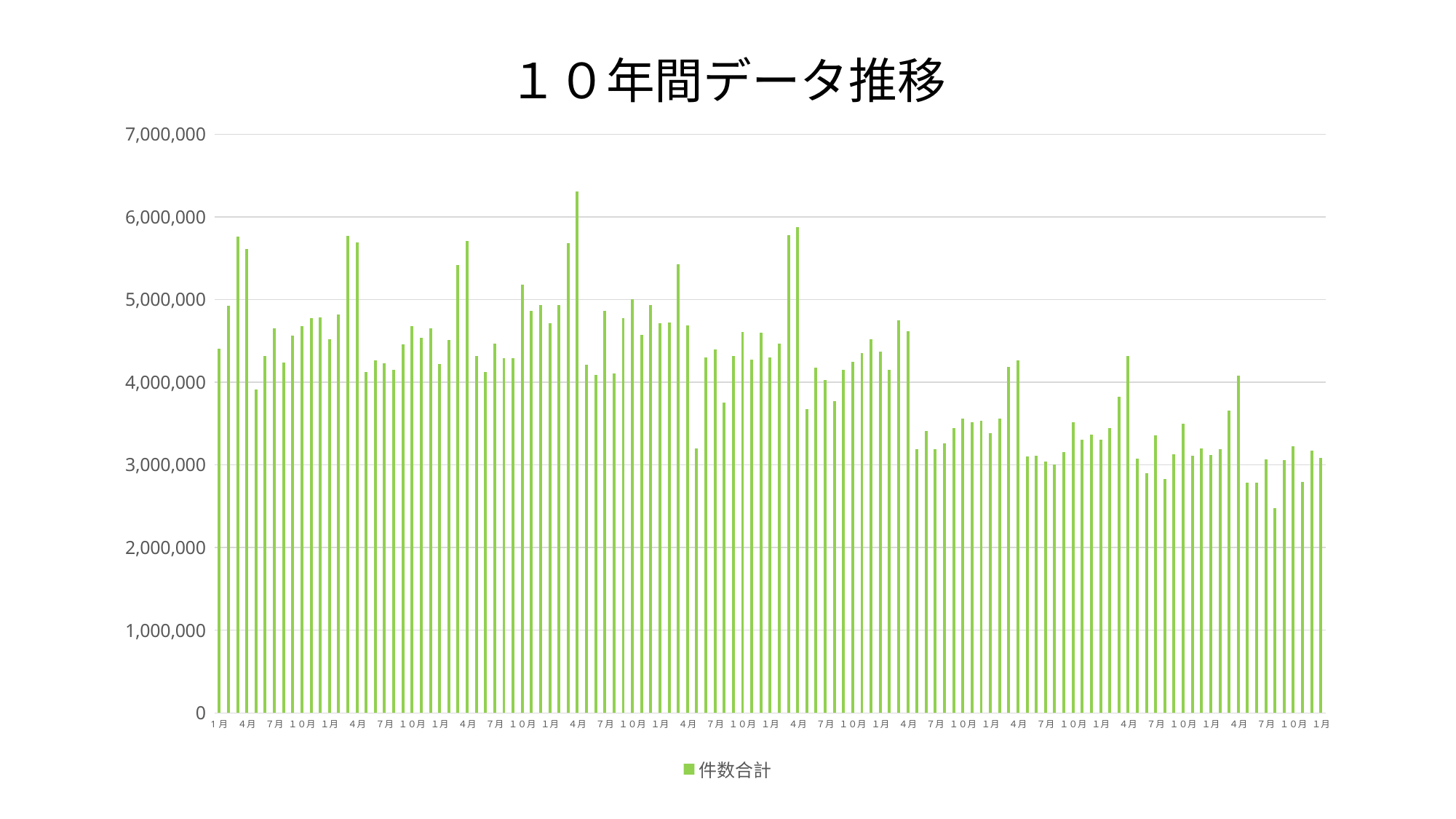
Is the value of the tallest bar greater or less than 6,000,000? greater Overall, do the values rise or fall from the left of the x axis to the right? fall What is the title of the chart? １０年間データ推移 Which is larger, the value of the leftmost bar or the value of the rightmost bar? the leftmost bar Is the value of the leftmost bar (the first 1月) greater or less than 4,000,000? greater Is the value of the shortest bar greater or less than 3,000,000? less How many series does the legend list? 1 What kind of chart is shown on the slide? bar chart What is the name of the series shown in the legend? 件数合計